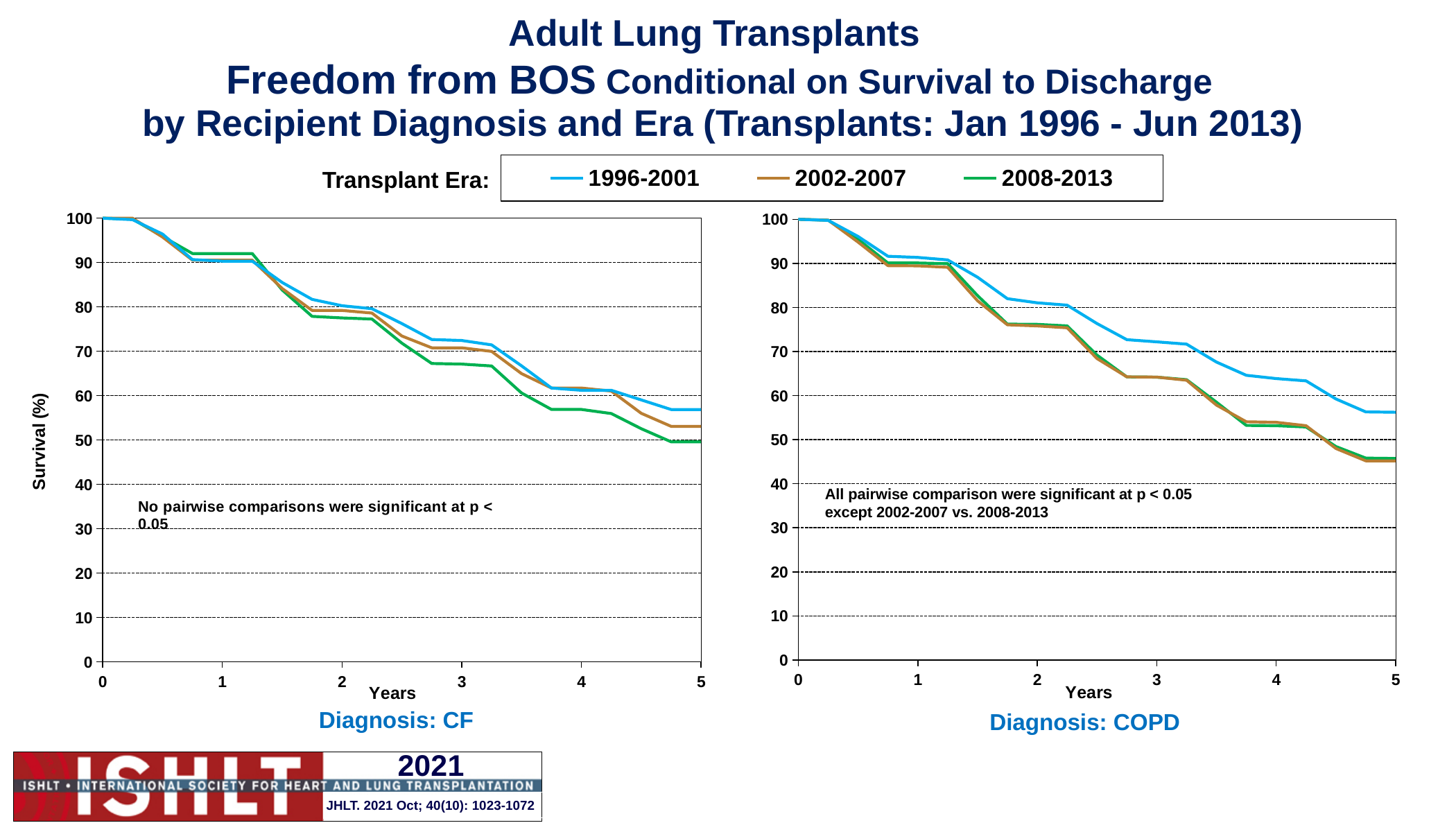
In the Diagnosis: COPD chart, is the value for 1996-2001 at 5 years greater or less than 50? greater In the Diagnosis: CF chart, is the value for 2008-2013 at 3 years greater or less than 70? less In the Diagnosis: CF chart, is the value for 2008-2013 at 5 years greater or less than 60? less In the Diagnosis: CF chart, which era has the higher value at 5 years, 1996-2001 or 2008-2013? 1996-2001 In the Diagnosis: COPD chart, which era has the higher value at 5 years, 1996-2001 or 2008-2013? 1996-2001 How many transplant eras does the legend list? 3 What kind of chart is the Diagnosis: CF chart? line chart What is the label on the y axis of the Diagnosis: CF chart? Survival (%) In the Diagnosis: COPD chart, do the survival values rise or fall as years increase? fall